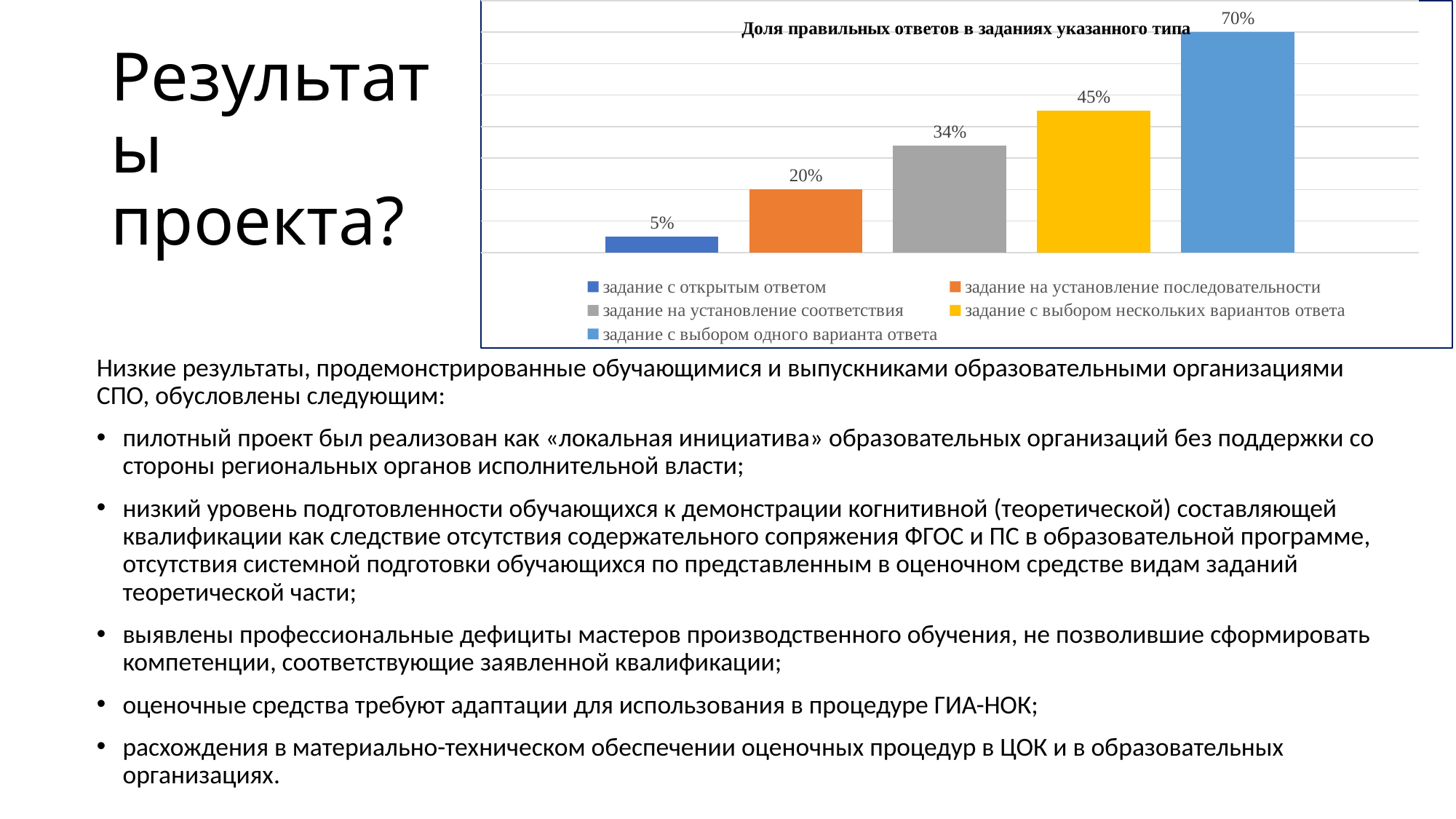
What is the difference between the share of correct answers for "задание с выбором одного варианта ответа" and "задание с выбором нескольких вариантов ответа"? 25% What is the title of the chart? Доля правильных ответов в заданиях указанного типа What is the share of correct answers for "задание с выбором нескольких вариантов ответа"? 45% What is the share of correct answers for "задание на установление соответствия"? 34% Which has a larger share of correct answers: "задание на установление соответствия" or "задание на установление последовательности"? задание на установление соответствия Which task type has the highest share of correct answers? задание с выбором одного варианта ответа What is the share of correct answers for "задание с выбором одного варианта ответа"? 70% What is the share of correct answers for "задание на установление последовательности"? 20% What type of chart is shown on the slide? Bar chart How many bars are shown in the chart? 5 Which task type has the lowest share of correct answers? задание с открытым ответом What is the share of correct answers for "задание с открытым ответом"? 5%